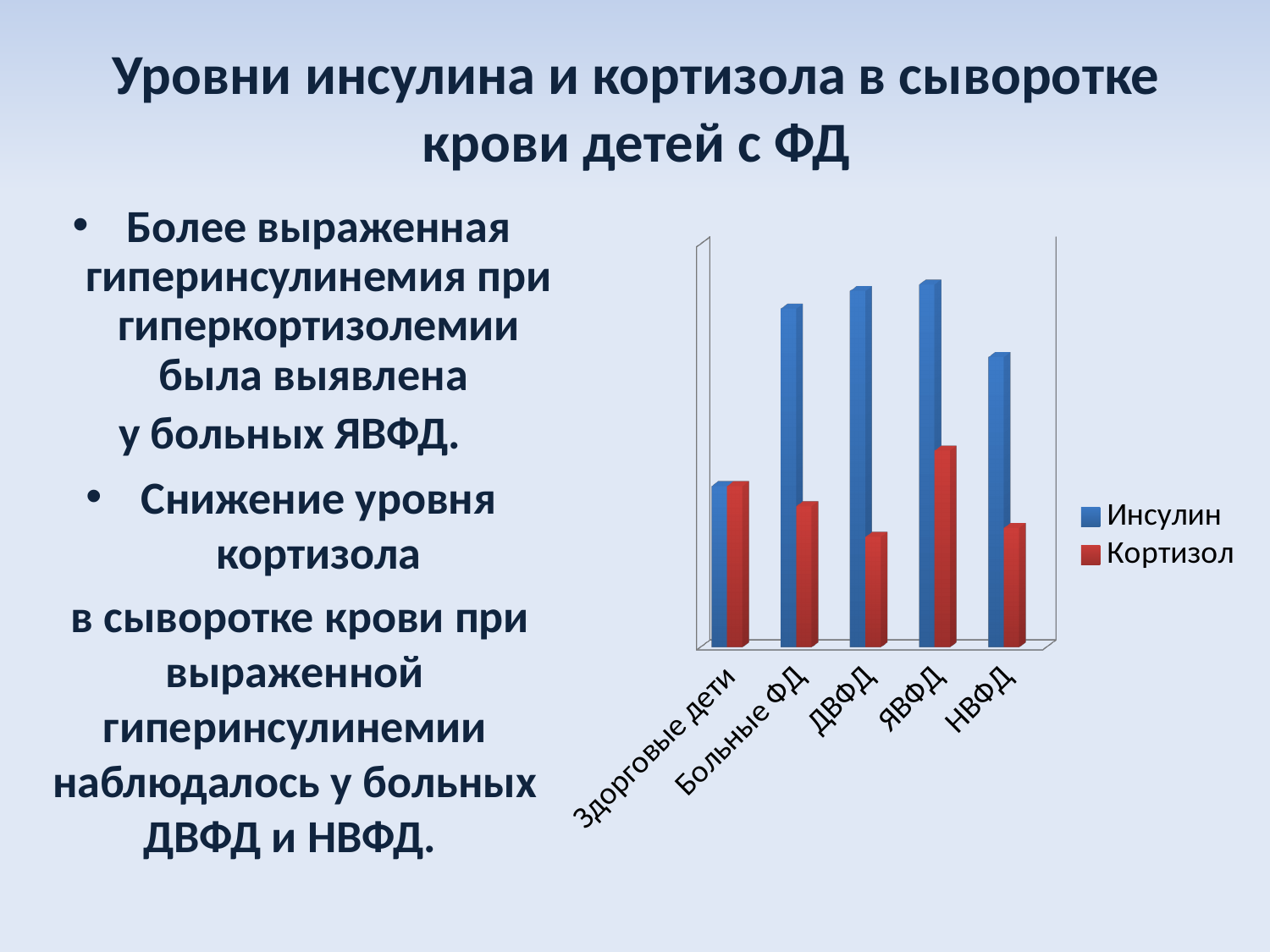
What kind of chart is shown on the slide? bar chart Which has the larger Инсулин value: ЯВФД or Здорговые дети? ЯВФД For ДВФД, which is larger: Инсулин or Кортизол? Инсулин Which category has the highest Кортизол value? ЯВФД Which category has the lowest Инсулин value? Здорговые дети How many series does the chart legend list? 2 Which colour represents the Кортизол series in the chart? red Which has the larger Кортизол value: ЯВФД or Больные ФД? ЯВФД How many categories are shown on the x axis of the chart? 5 What are the two series named in the chart legend? Инсулин and Кортизол